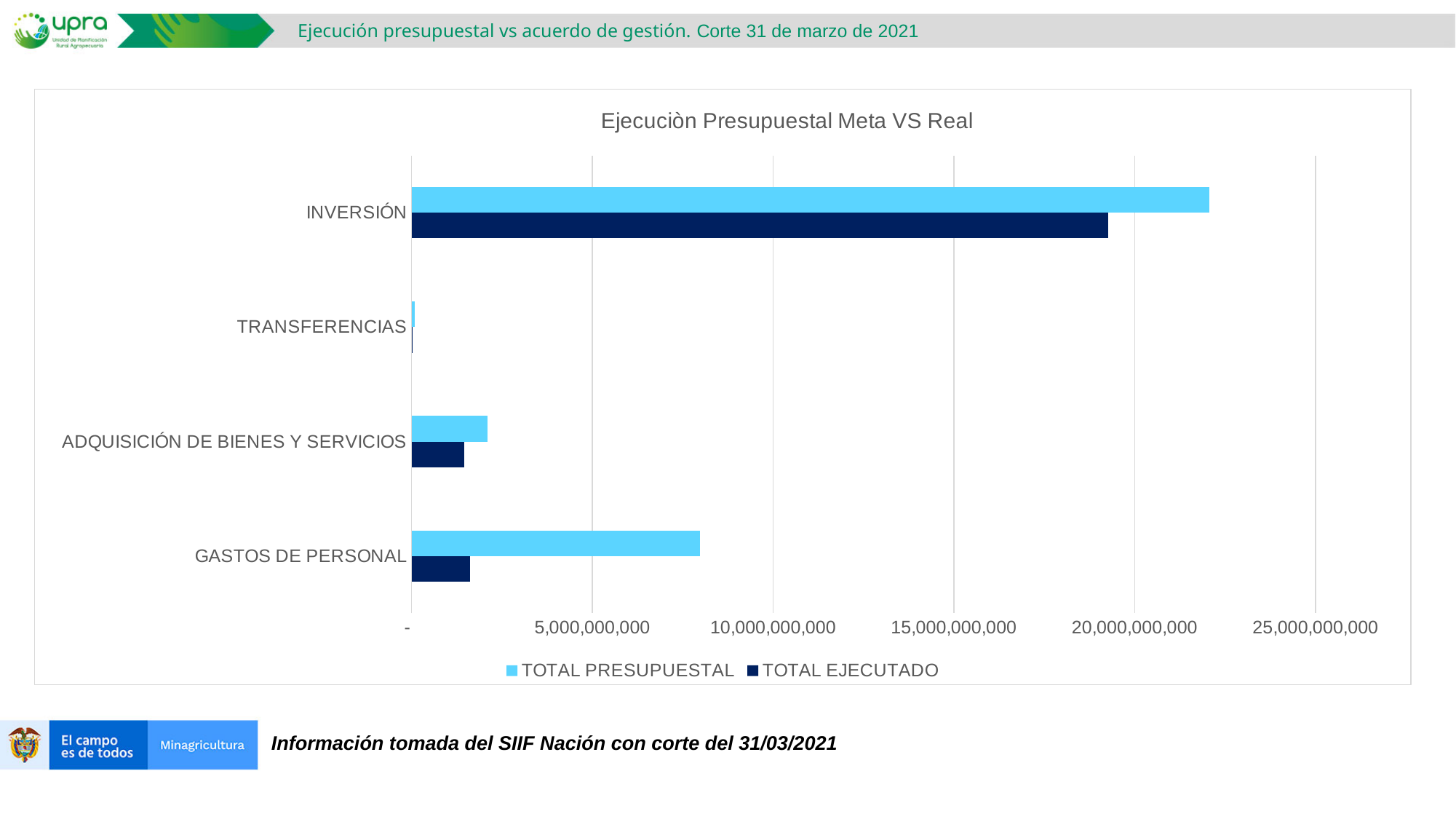
Is the TOTAL PRESUPUESTAL value for GASTOS DE PERSONAL greater or less than 5,000,000,000? greater Is the TOTAL PRESUPUESTAL value for INVERSIÓN greater or less than 20,000,000,000? greater How many categories are shown on the chart? 4 What is the title of the chart? Ejecuciòn Presupuestal Meta VS Real Which category has the highest TOTAL PRESUPUESTAL value? INVERSIÓN Which category has the larger TOTAL PRESUPUESTAL value: GASTOS DE PERSONAL or ADQUISICIÓN DE BIENES Y SERVICIOS? GASTOS DE PERSONAL Is the TOTAL EJECUTADO value for INVERSIÓN greater or less than 20,000,000,000? less How many series does the chart legend list? 2 What kind of chart is shown on the slide? bar chart Which category has the highest TOTAL EJECUTADO value? INVERSIÓN Which is larger for GASTOS DE PERSONAL: TOTAL PRESUPUESTAL or TOTAL EJECUTADO? TOTAL PRESUPUESTAL Which category has the lowest TOTAL PRESUPUESTAL value? TRANSFERENCIAS